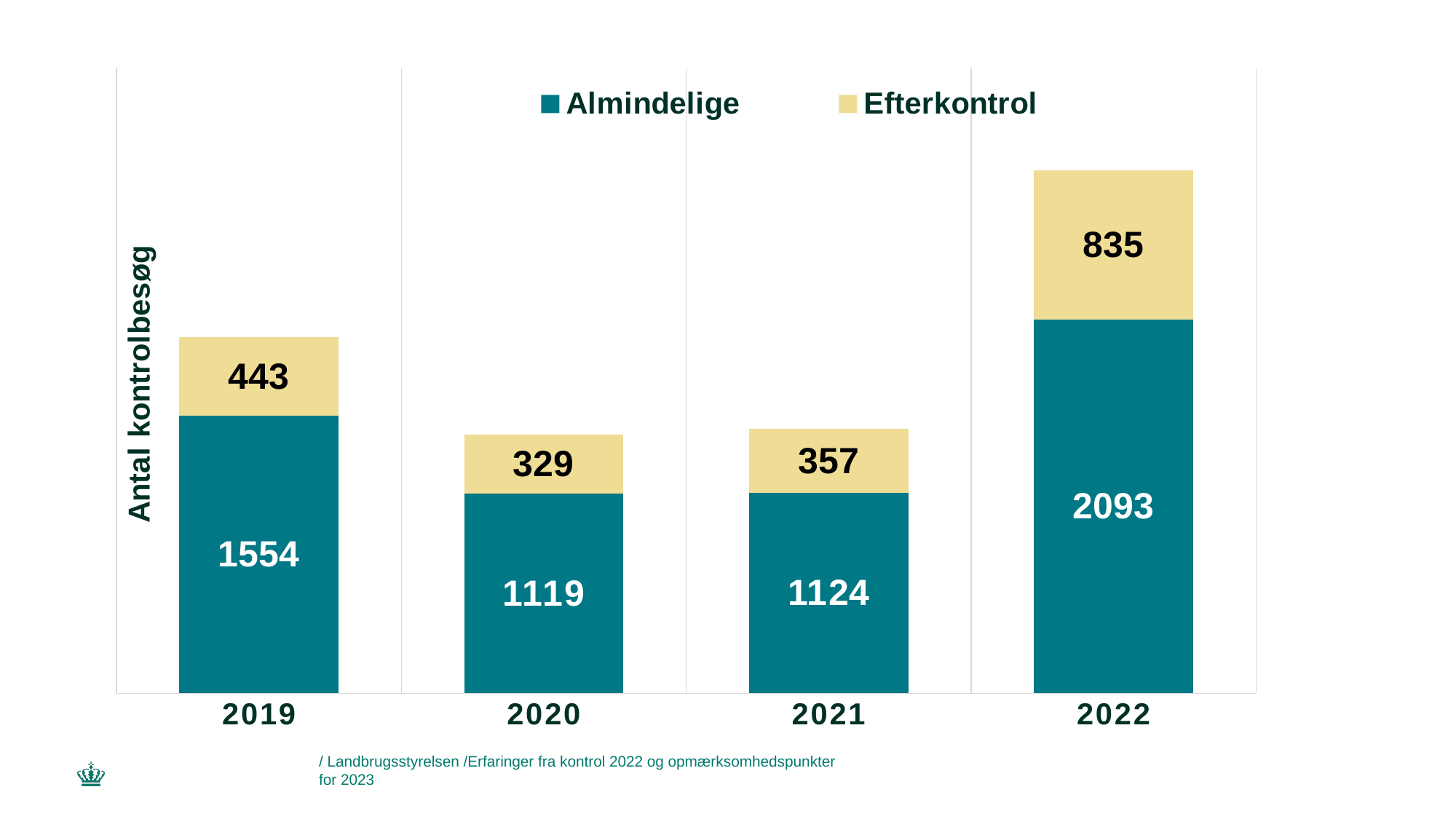
Which is larger, the Almindelige value for 2020 or for 2021? 2021 How many years are shown on the x axis? 4 What is the value for Almindelige in 2022? 2093 Which year has the highest value for Efterkontrol? 2022 What is the label on the vertical axis? Antal kontrolbesøg What is the value for Efterkontrol in 2020? 329 What is the value for Almindelige in 2019? 1554 What kind of chart is shown on the slide? Stacked bar chart Which year has the lowest value for Almindelige? 2020 How many series does the legend list? 2 What is the difference between the Efterkontrol values for 2022 and 2019? 392 What is the total of the stacked bar for 2022? 2928